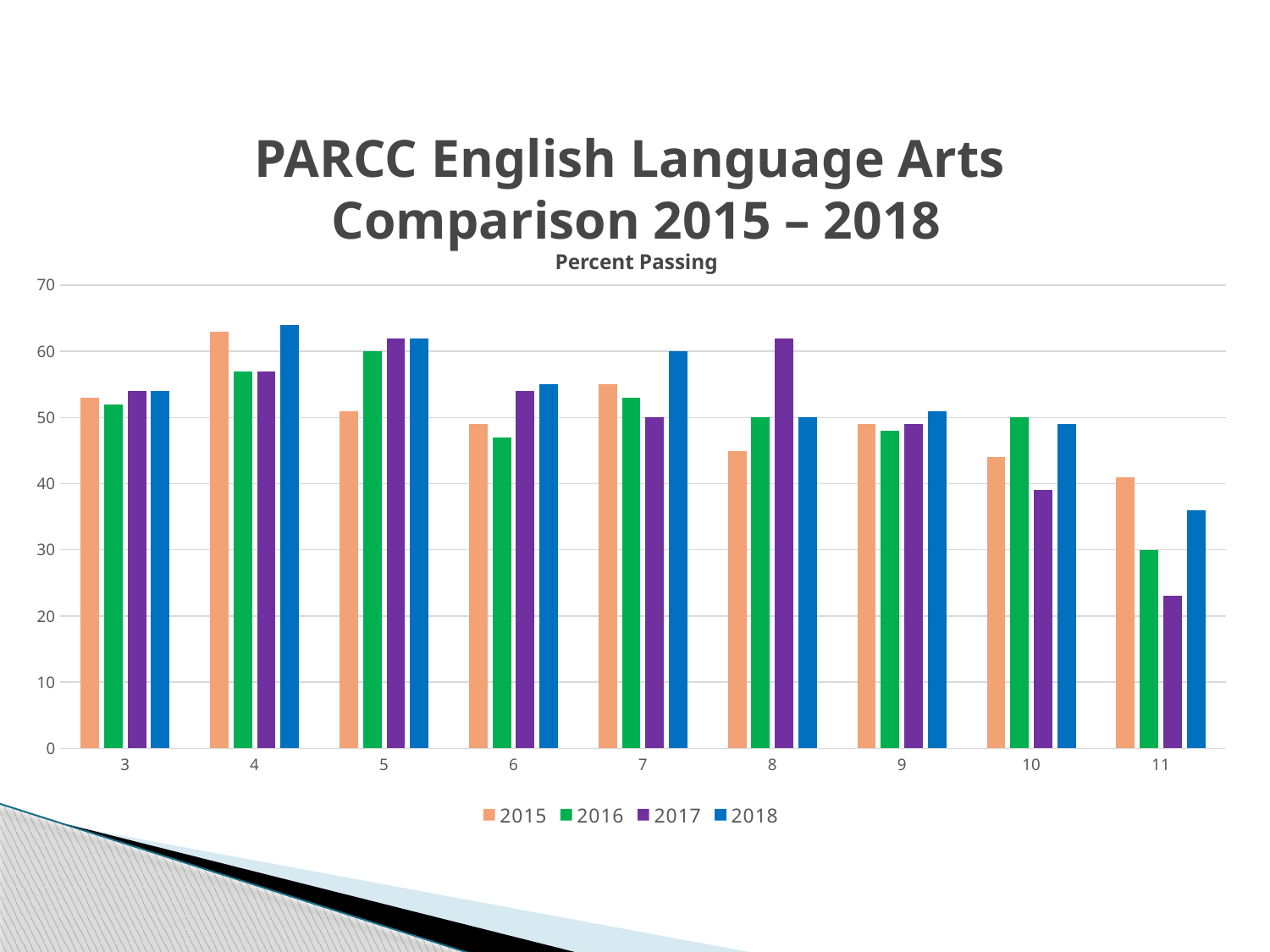
Which years are listed in the legend? 2015, 2016, 2017, 2018 Is the 2017 value for grade 11 greater or less than 30? less How many grade categories are shown on the x axis? 9 What kind of chart is shown on the slide? bar chart Is the 2015 value for grade 8 greater or less than 50? less For grade 11, which year has the lowest value? 2017 What is the subtitle shown above the chart's plot area? Percent Passing How many series does the legend list? 4 Is the 2018 value for grade 4 greater or less than 60? greater For grade 8, which year has the highest value? 2017 For grade 6, which is larger: the 2016 value or the 2018 value? 2018